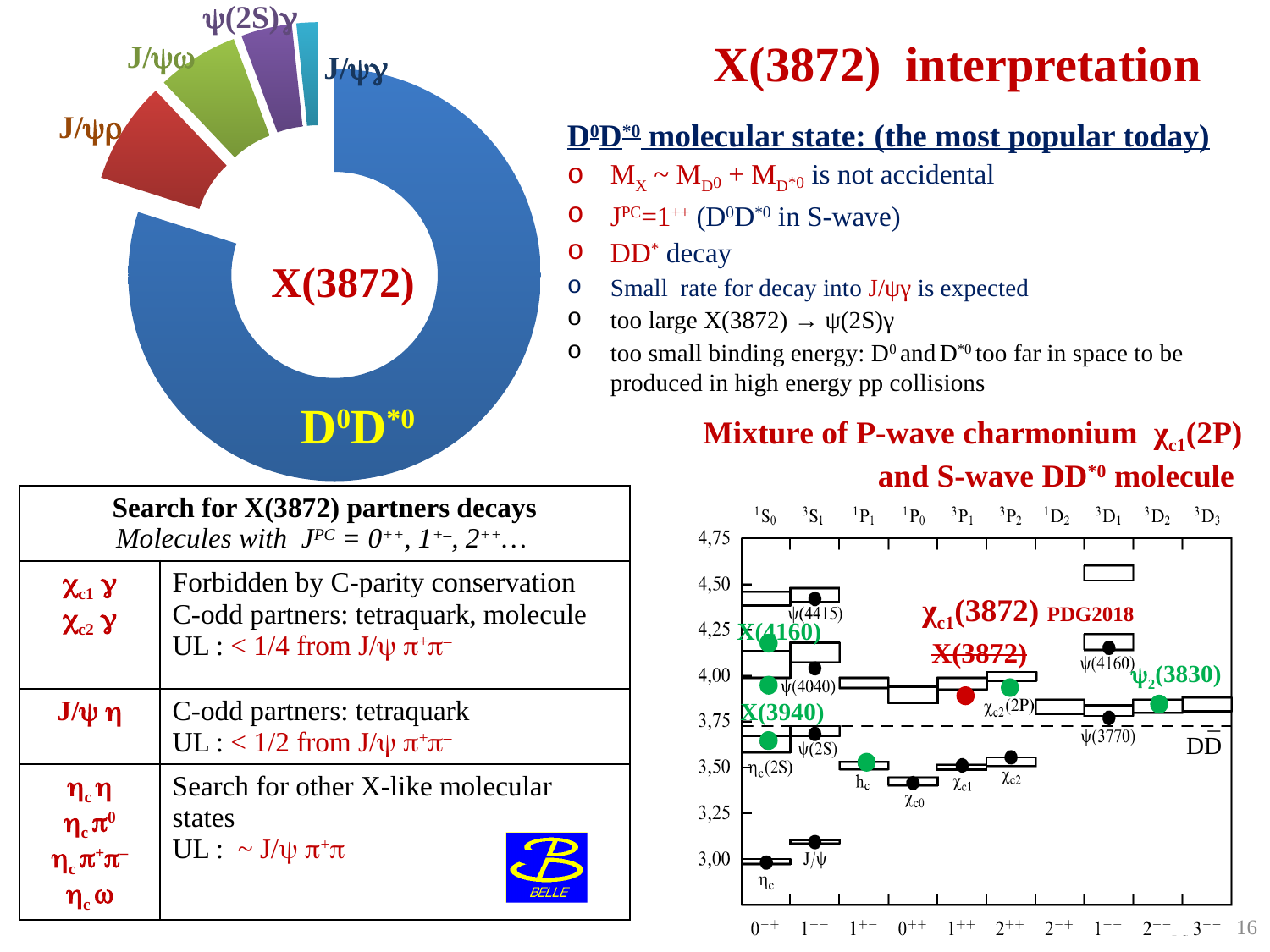
What label is written in the centre of the doughnut chart on the left? X(3872) In the X(3872) doughnut chart, which slice is larger: J/ψω or J/ψγ? J/ψω What kind of chart is the chart on the left of the slide labelled X(3872)? doughnut (pie) chart How many slices does the X(3872) doughnut chart have? 5 Which decay mode has the largest slice in the X(3872) doughnut chart? D0D*0 What colour is the D0D*0 slice in the X(3872) doughnut chart? blue Does the D0D*0 slice take up more or less than half of the X(3872) doughnut chart? more In the X(3872) doughnut chart, which slice is larger: J/ψρ or ψ(2S)γ? J/ψρ In the X(3872) doughnut chart, which slice is larger: D0D*0 or J/ψρ? D0D*0 Which decay mode has the smallest slice in the X(3872) doughnut chart? J/ψγ